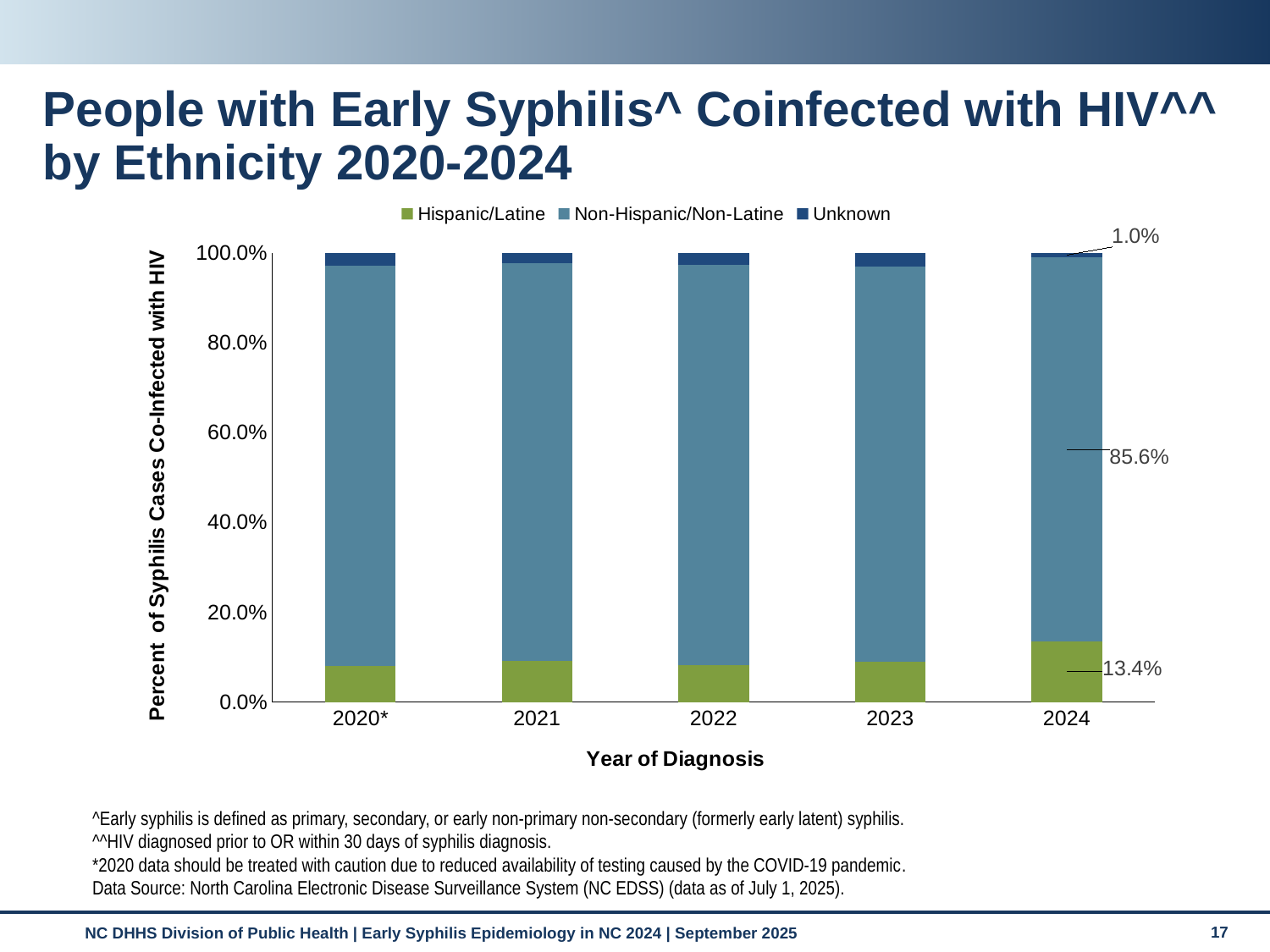
What type of chart is shown on the slide? Stacked bar chart Is the Non-Hispanic/Non-Latine share in 2021 greater or less than 80.0%? greater What percentage of people with early syphilis coinfected with HIV in 2024 were Non-Hispanic/Non-Latine? 85.6% What percentage of the 2024 bar is labelled Unknown ethnicity? 1.0% How many years of diagnosis are shown on the x axis? 5 Which year has the largest Hispanic/Latine share? 2024 What is the total of the three labelled segments in the 2024 bar? 100.0% In 2024, which is larger: the Hispanic/Latine share or the Non-Hispanic/Non-Latine share? Non-Hispanic/Non-Latine How many ethnicity series does the legend list? 3 In 2024, how many percentage points higher is the Non-Hispanic/Non-Latine share than the Hispanic/Latine share? 72.2 percentage points Is the Hispanic/Latine share in 2020 greater or less than 20.0%? less What percentage of people with early syphilis coinfected with HIV in 2024 were Hispanic/Latine? 13.4%